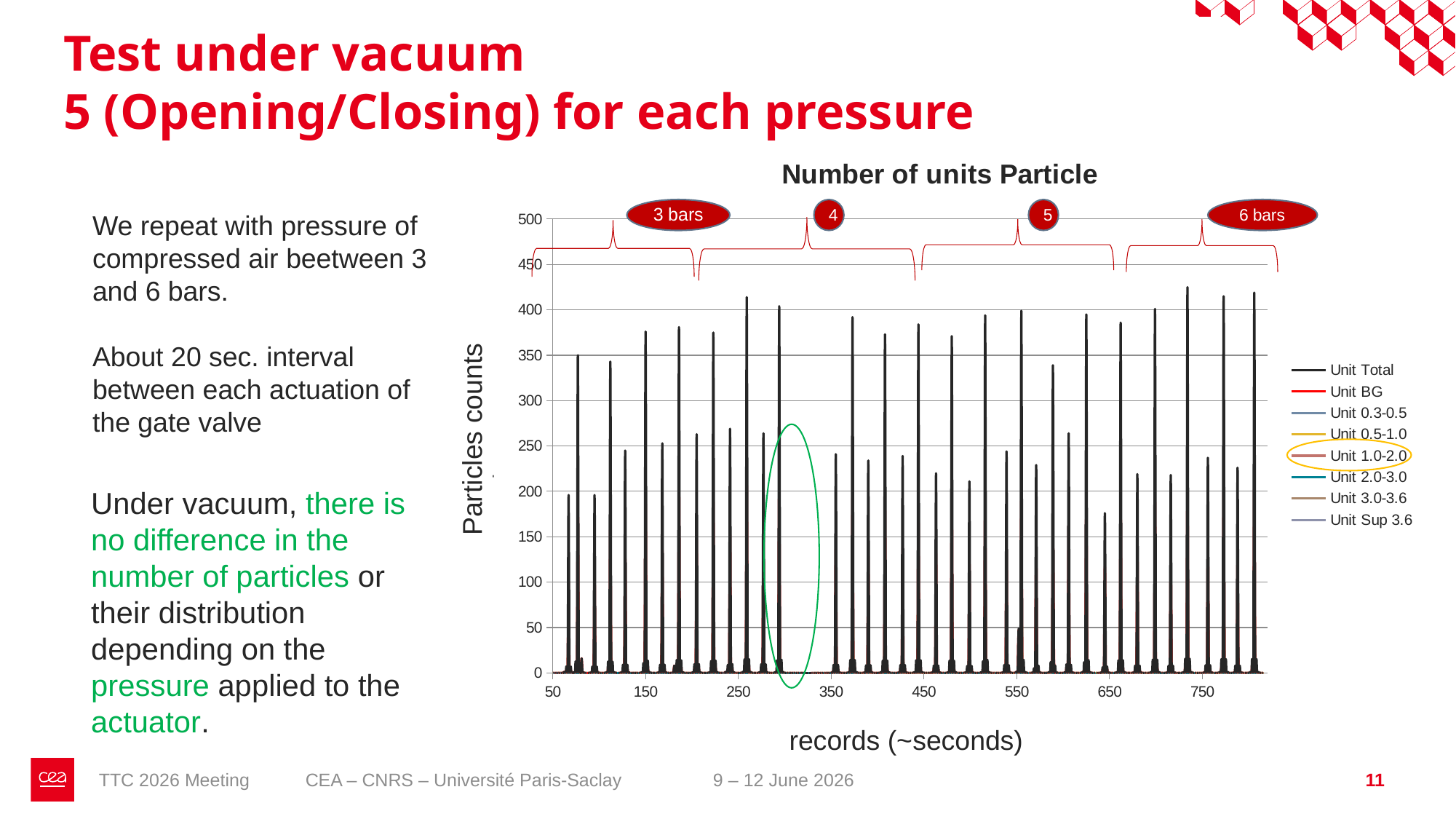
How many series does the chart legend list? 8 What pressure label is shown in the leftmost red oval above the chart? 3 bars What is the first entry listed in the chart legend? Unit Total What kind of chart is shown on the slide? line chart What is the label of the x axis of the chart? records (~seconds) Is the tallest peak of the Unit Total series greater or less than 350? greater Is the tallest peak of the Unit Total series greater or less than 450? less